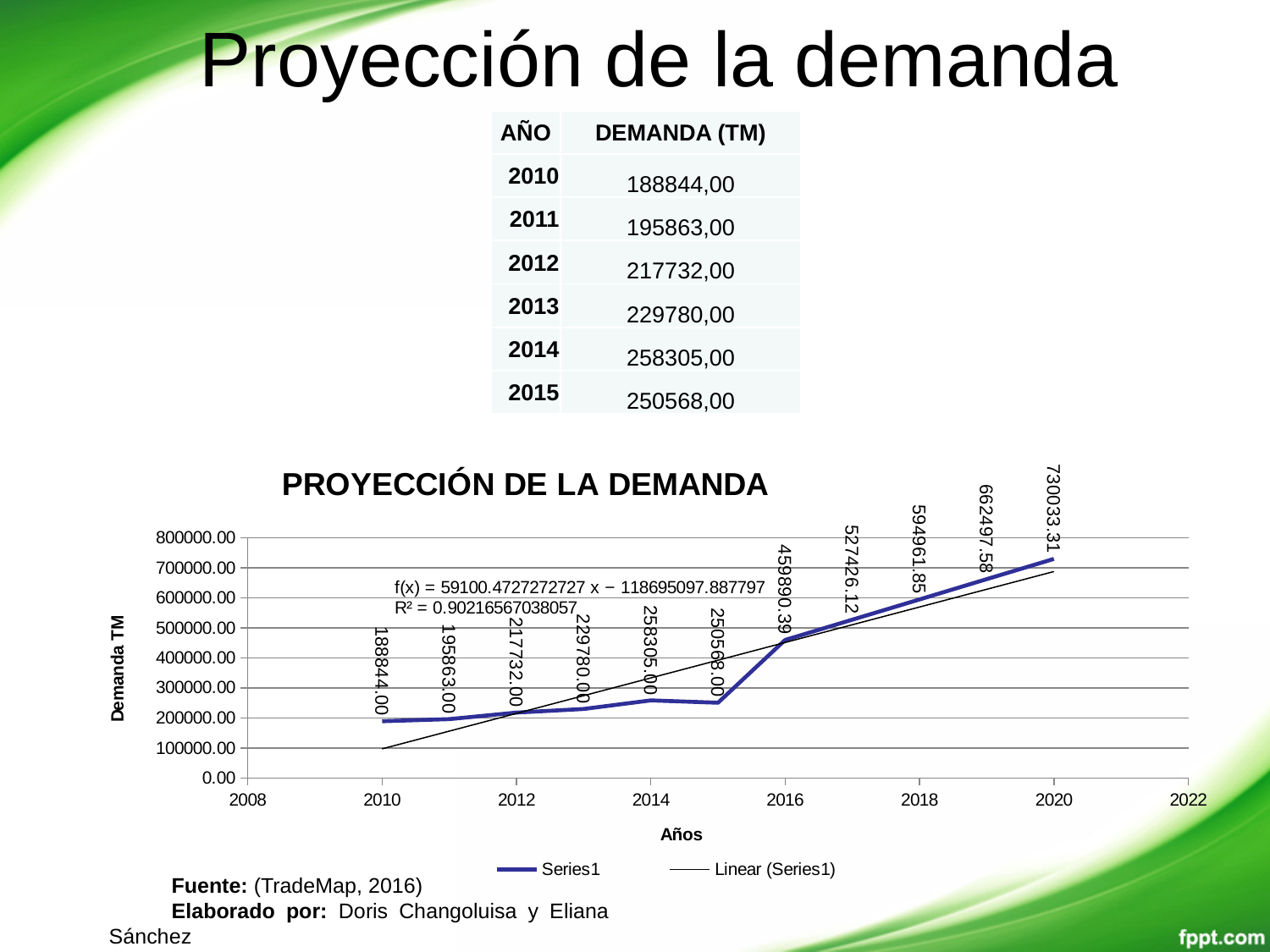
What is the value plotted for 2016? 459890.39 What is the difference between the values for 2014 and 2015? 7737.00 Which is larger, the value for 2014 or the value for 2015? 2014 What is the value plotted for 2010? 188844.00 Which year has the highest plotted value? 2020 How many entries does the chart legend list? 2 What is the title of the chart? PROYECCIÓN DE LA DEMANDA What is the label of the vertical axis? Demanda TM What is the value plotted for 2020? 730033.31 What type of chart is shown on the slide? Line chart How many data points are labelled on the Series1 line? 11 Which year has the lowest plotted value? 2010